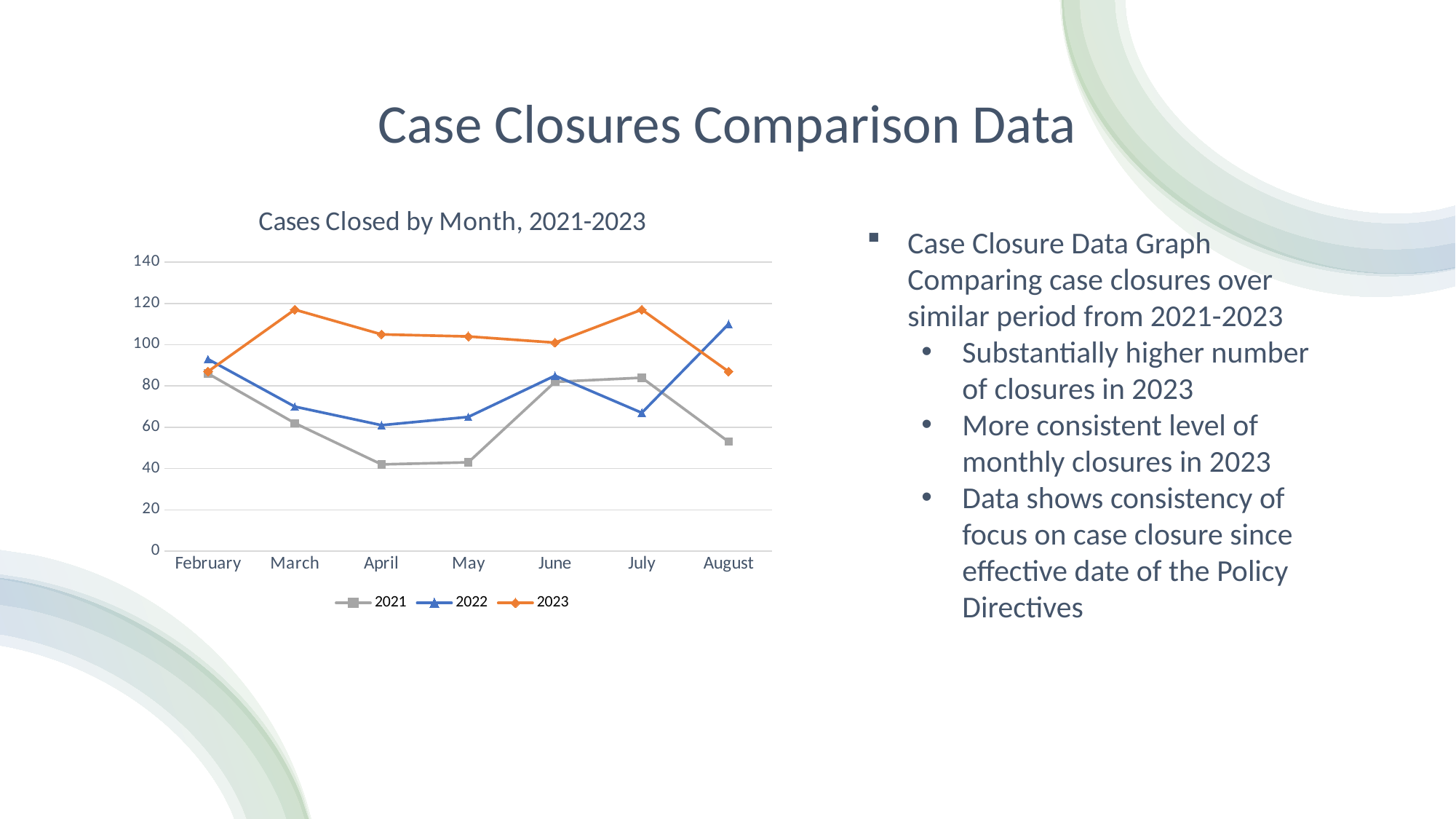
Which month has the highest value for the 2022 series? August In August, which series has the larger value, 2022 or 2023? 2022 How many series does the chart's legend list? 3 Is the value for 2021 in April greater or less than 60? less What kind of chart is shown on the slide? Line chart Which colour is used for the 2023 series in the chart? Orange What is the title of the chart? Cases Closed by Month, 2021-2023 How many months are shown on the x axis of the chart? 7 Is the value for 2023 in March greater or less than 100? greater Does the 2021 series rise or fall from February to April? Fall In April, which series has the larger value, 2021 or 2023? 2023 Is the value for 2022 in August greater or less than 100? greater